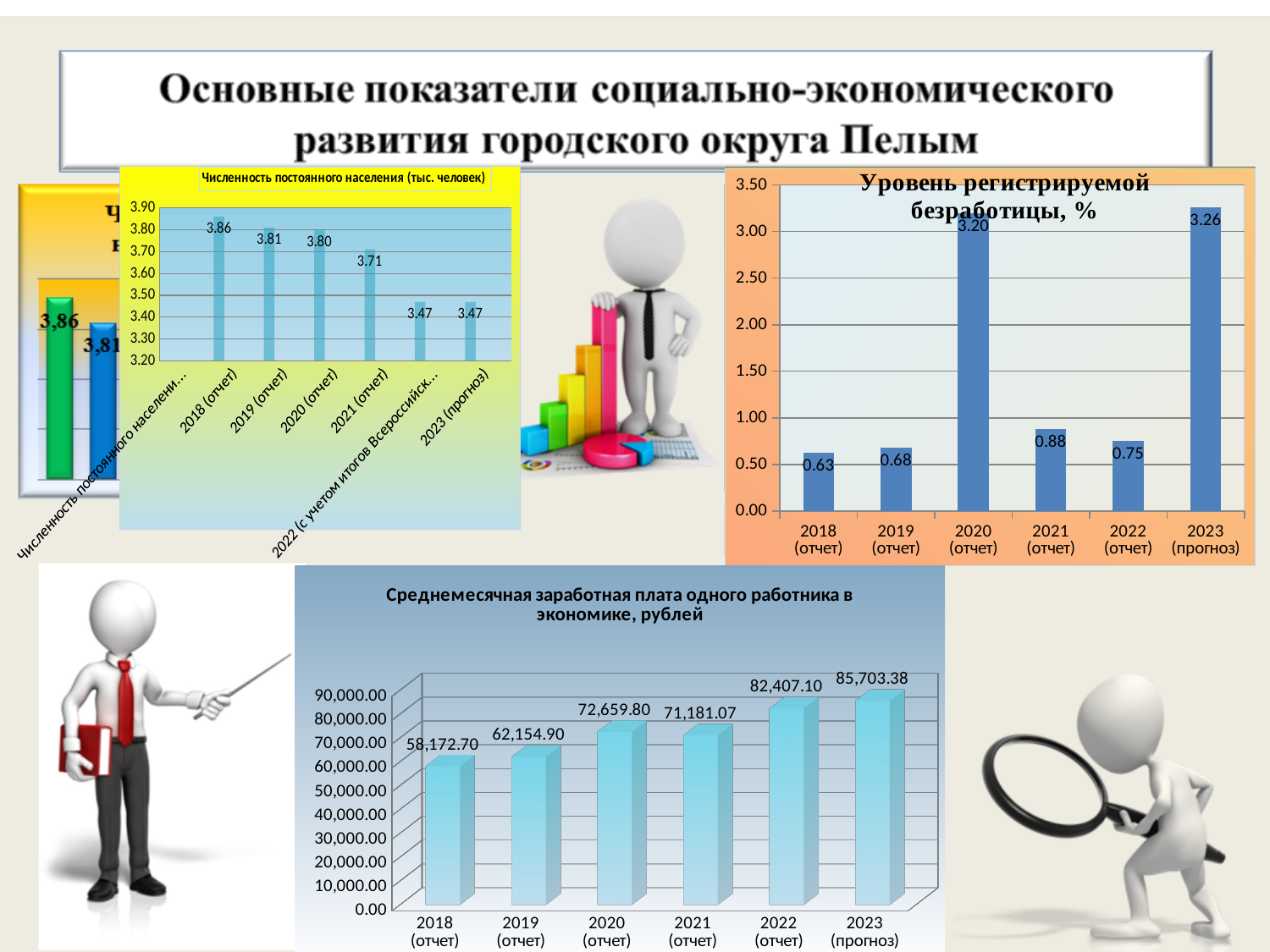
On the chart 'Среднемесячная заработная плата одного работника в экономике, рублей', what is the value for 2022 (отчет)? 82,407.10 On the chart 'Численность постоянного населения (тыс. человек)', what is the value for 2018 (отчет)? 3.86 On the chart 'Среднемесячная заработная плата одного работника в экономике, рублей', which is larger: the value for 2020 (отчет) or 2021 (отчет)? 2020 (отчет) On the chart 'Среднемесячная заработная плата одного работника в экономике, рублей', what is the difference between the values for 2023 (прогноз) and 2018 (отчет)? 27,530.68 On the chart 'Численность постоянного населения (тыс. человек)', do the values generally rise or fall from 2018 to 2023? fall On the chart 'Численность постоянного населения (тыс. человек)', what is the value for 2023 (прогноз)? 3.47 On the chart 'Уровень регистрируемой безработицы, %', what is the value for 2020 (отчет)? 3.20 What kind of chart is 'Среднемесячная заработная плата одного работника в экономике, рублей'? bar chart On the chart 'Уровень регистрируемой безработицы, %', how many years are shown on the x axis? 6 On the chart 'Уровень регистрируемой безработицы, %', what is the difference between the values for 2021 (отчет) and 2022 (отчет)? 0.13 On the chart 'Уровень регистрируемой безработицы, %', which year has the lowest value? 2018 (отчет) On the chart 'Уровень регистрируемой безработицы, %', which year has the highest value? 2023 (прогноз)